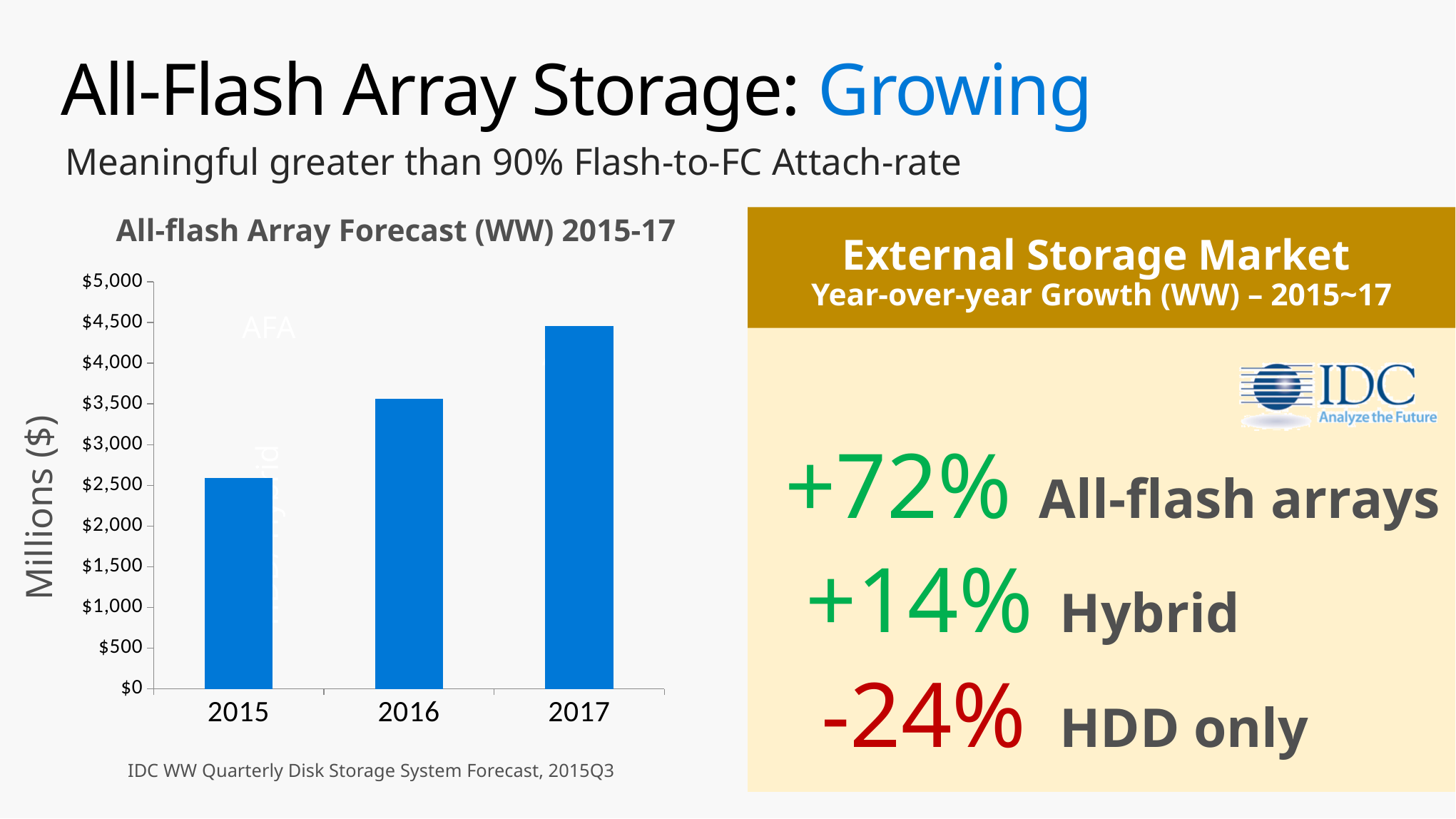
In the All-flash Array Forecast chart, is the value for 2016 greater or less than $3,000? greater Do the values in the All-flash Array Forecast chart rise or fall from 2015 to 2017? rise In the All-flash Array Forecast chart, is the value for 2015 greater or less than $2,000? greater How many years are shown on the x axis of the All-flash Array Forecast chart? 3 In the All-flash Array Forecast chart, is the value for 2017 greater or less than $4,000? greater In the All-flash Array Forecast chart, which is larger, the value for 2016 or the value for 2017? 2017 Which year has the highest value in the All-flash Array Forecast chart? 2017 What kind of chart is the All-flash Array Forecast (WW) 2015-17 chart? bar chart What is the y-axis label of the All-flash Array Forecast chart? Millions ($) Which year has the lowest value in the All-flash Array Forecast chart? 2015